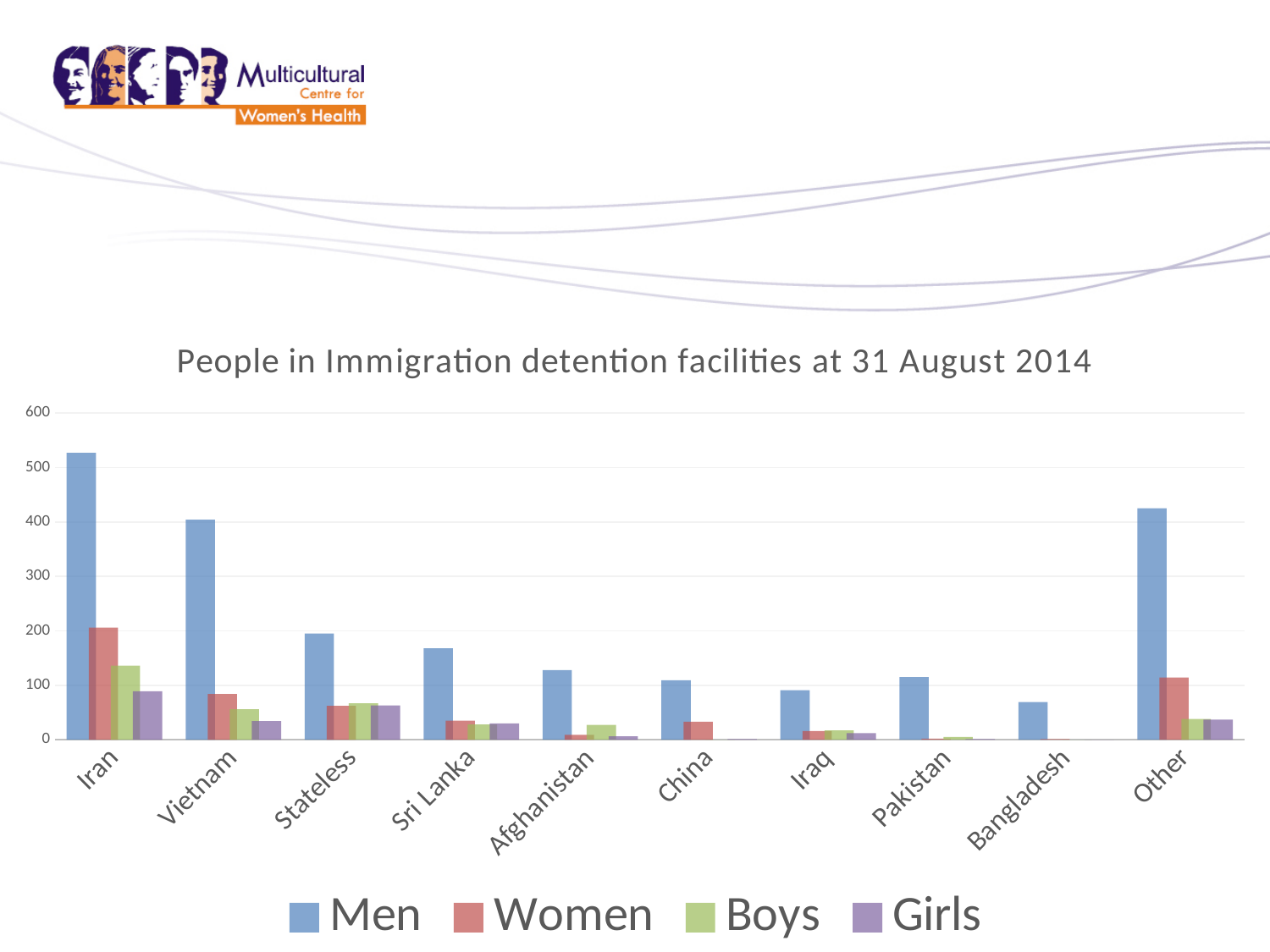
How many series does the legend list? 4 Is the value for Women in Iran greater or less than 100? greater Which category has the highest value for Boys? Iran Is the value for Men in Iran greater or less than 500? greater Which category has the lowest value for Men? Bangladesh Which is larger, the value for Men in Iran or the value for Men in Other? Iran Is the value for Men in Vietnam greater or less than 300? greater How many categories are shown on the x axis? 10 Which category has the highest value for Men? Iran What kind of chart is shown on the slide? bar chart What is the title of the chart? People in Immigration detention facilities at 31 August 2014 Which category has the highest value for Women? Iran